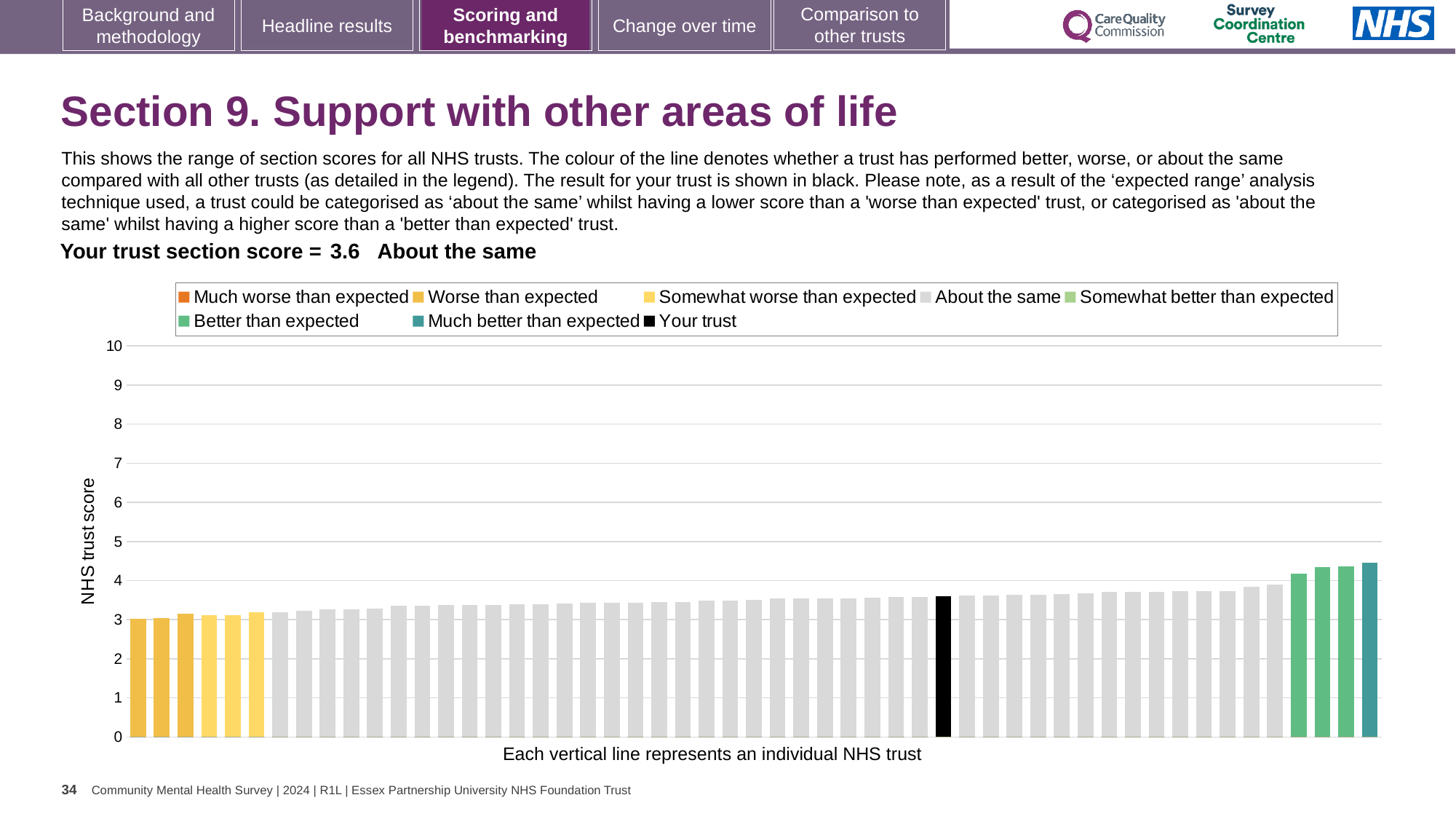
Which legend category does the tallest bar on the chart belong to? Much better than expected Is the value for your trust (the black bar) greater or less than 3? greater Is the value of the tallest bar (far right) greater or less than 4? greater What colour is used for the 'Your trust' bar in the chart? black How many entries does the chart legend list? 8 What is the label on the vertical axis of the chart? NHS trust score Do the bar values rise or fall from left to right along the x axis? rise Is the value for your trust (the black bar) greater or less than 4? less What is the section score for your trust shown on the slide? 3.6 What kind of chart is shown on the slide? bar chart How many bars are coloured as 'Much better than expected' (teal)? 1